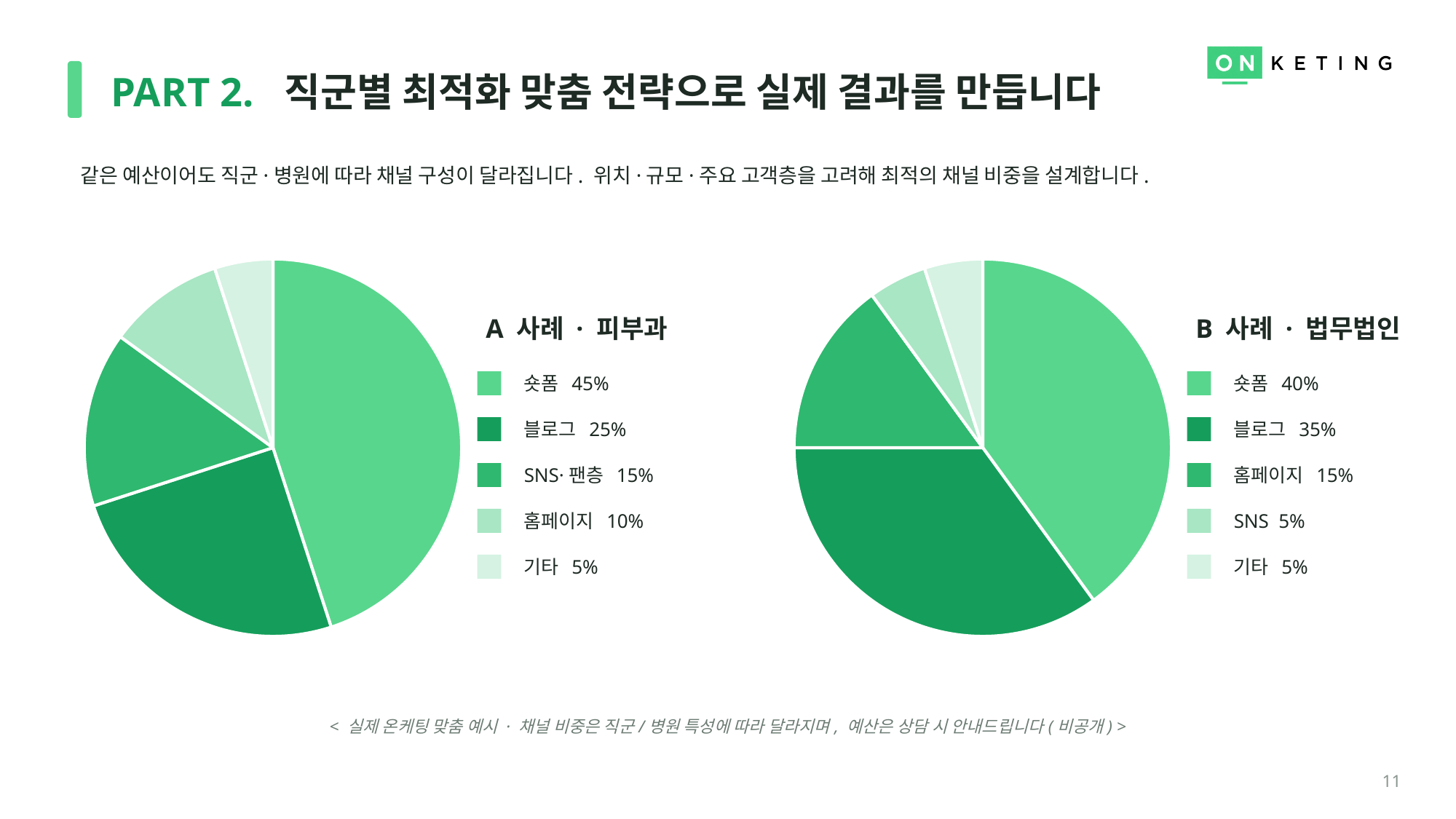
In the 'A 사례 · 피부과' pie chart, which category has the largest share? 숏폼 What kind of chart is used for 'B 사례 · 법무법인'? Pie chart Which is larger: the 홈페이지 share in the 'A 사례 · 피부과' chart or the 홈페이지 share in the 'B 사례 · 법무법인' chart? B 사례 · 법무법인 In the 'A 사례 · 피부과' pie chart, which category has the smallest share? 기타 In the 'B 사례 · 법무법인' pie chart, what share does 블로그 have? 35% In the 'B 사례 · 법무법인' pie chart, what is the difference between the 숏폼 share and the 블로그 share? 5% In the 'A 사례 · 피부과' pie chart, what share does 숏폼 have? 45% How many categories does the 'B 사례 · 법무법인' pie chart have? 5 How many categories does the 'A 사례 · 피부과' pie chart have? 5 In the 'B 사례 · 법무법인' pie chart, what share does SNS have? 5% In the 'A 사례 · 피부과' pie chart, what is the difference between the 숏폼 share and the 블로그 share? 20% In the 'B 사례 · 법무법인' pie chart, which category has the largest share? 숏폼